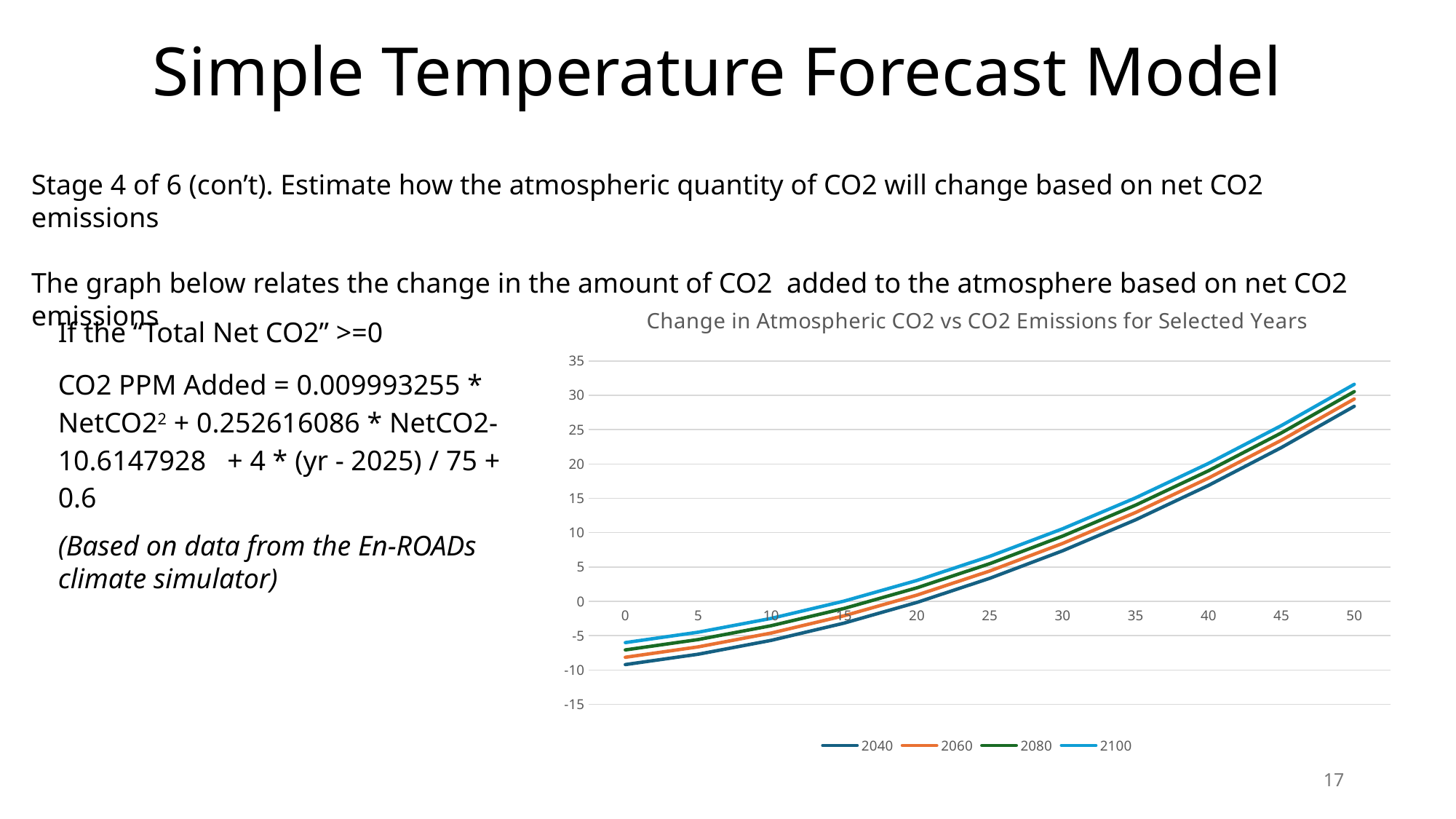
Which series has the lowest value at x = 0? 2040 Is the value for the 2100 series at x = 50 greater or less than 30? greater Which series has the highest value at x = 50? 2100 What is the title of the chart? Change in Atmospheric CO2 vs CO2 Emissions for Selected Years Is the value for the 2040 series at x = 0 greater or less than -5? less Is the value for the 2040 series at x = 15 greater or less than 0? less How many series does the legend list? 4 What kind of chart is shown on the slide? line chart Which years are listed in the chart legend? 2040, 2060, 2080, 2100 Do the values for the 2040 series rise or fall as the x axis increases from 0 to 50? rise At x = 25, which series is larger, 2040 or 2100? 2100